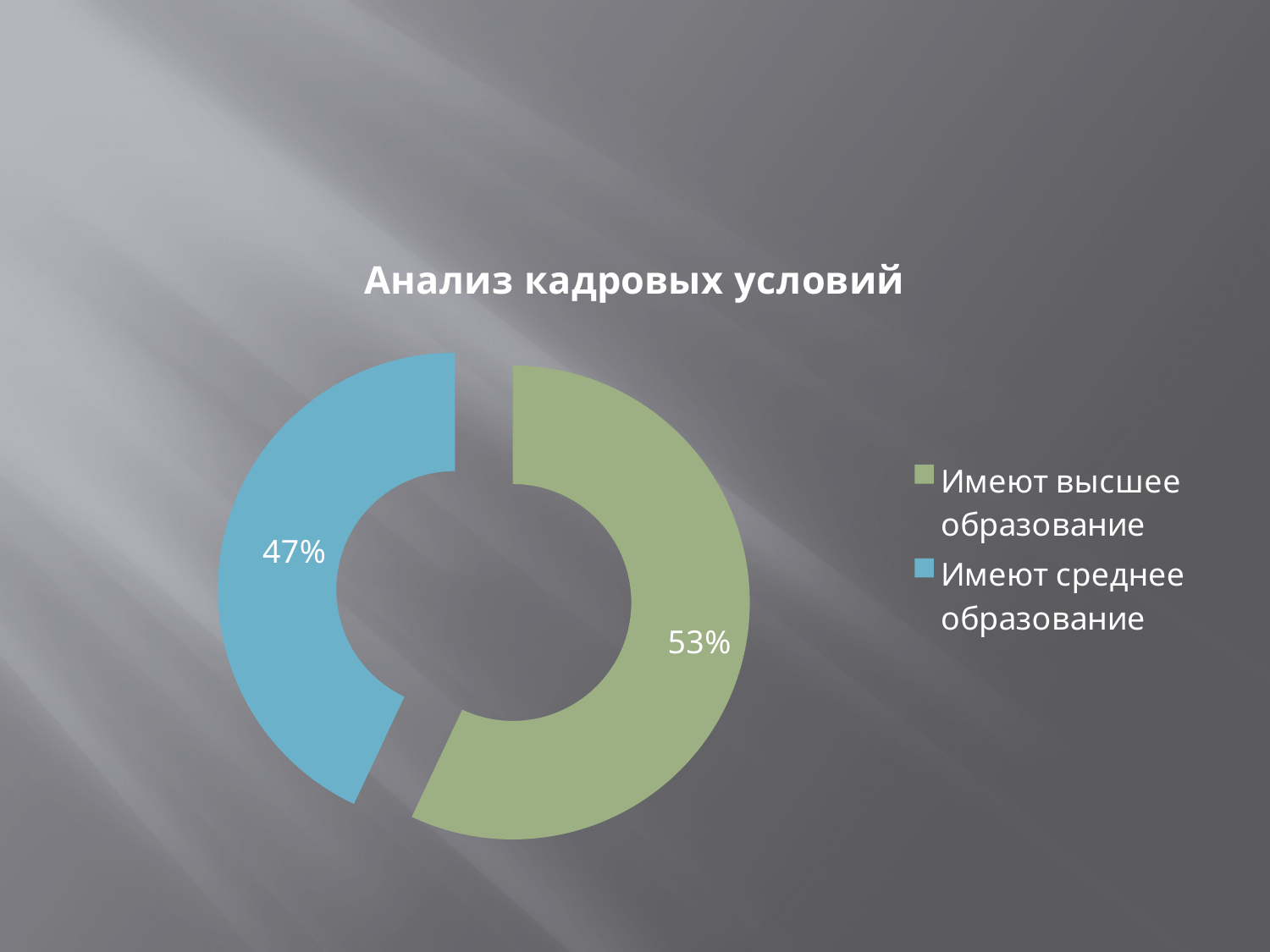
How many categories does the chart show? 2 What kind of chart is shown on the slide? Doughnut (pie) chart What colour is the slice for "Имеют среднее образование"? Blue Which category has the smallest share? Имеют среднее образование What share of the chart is labelled "Имеют высшее образование"? 53% What is the difference in percentage points between "Имеют высшее образование" and "Имеют среднее образование"? 6 Which is larger: the share for "Имеют высшее образование" or for "Имеют среднее образование"? Имеют высшее образование Is the share for "Имеют высшее образование" greater or less than 50%? greater How many entries does the legend list? 2 Which category has the largest share? Имеют высшее образование What share of the chart is labelled "Имеют среднее образование"? 47% What is the title of the chart? Анализ кадровых условий